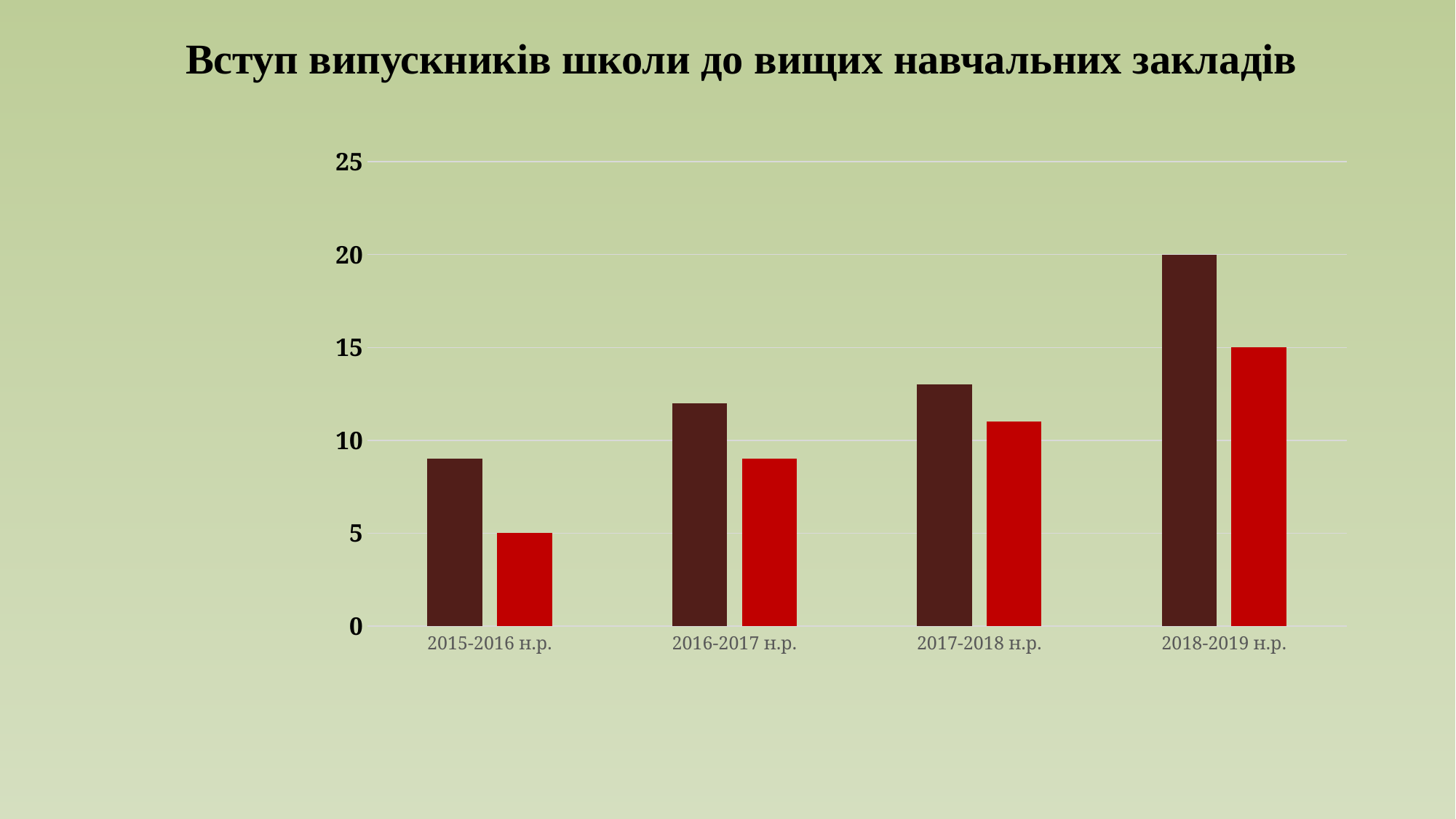
Which academic year has the lowest red bar? 2015-2016 н.р. Is the value of the dark brown bar for 2016-2017 н.р. greater or less than 10? greater What is the value of the red bar for 2015-2016 н.р.? 5 What is the value of the dark brown bar for 2018-2019 н.р.? 20 How many academic-year categories are shown on the x axis? 4 What is the difference between the dark brown bar and the red bar for 2018-2019 н.р.? 5 Do the dark brown bars rise or fall from 2015-2016 н.р. to 2018-2019 н.р.? rise What is the title of the chart? Вступ випускників школи до вищих навчальних закладів What is the value of the red bar for 2018-2019 н.р.? 15 How many bars are shown for each academic year? 2 What type of chart is shown on the slide? bar chart Which academic year has the highest dark brown bar? 2018-2019 н.р.